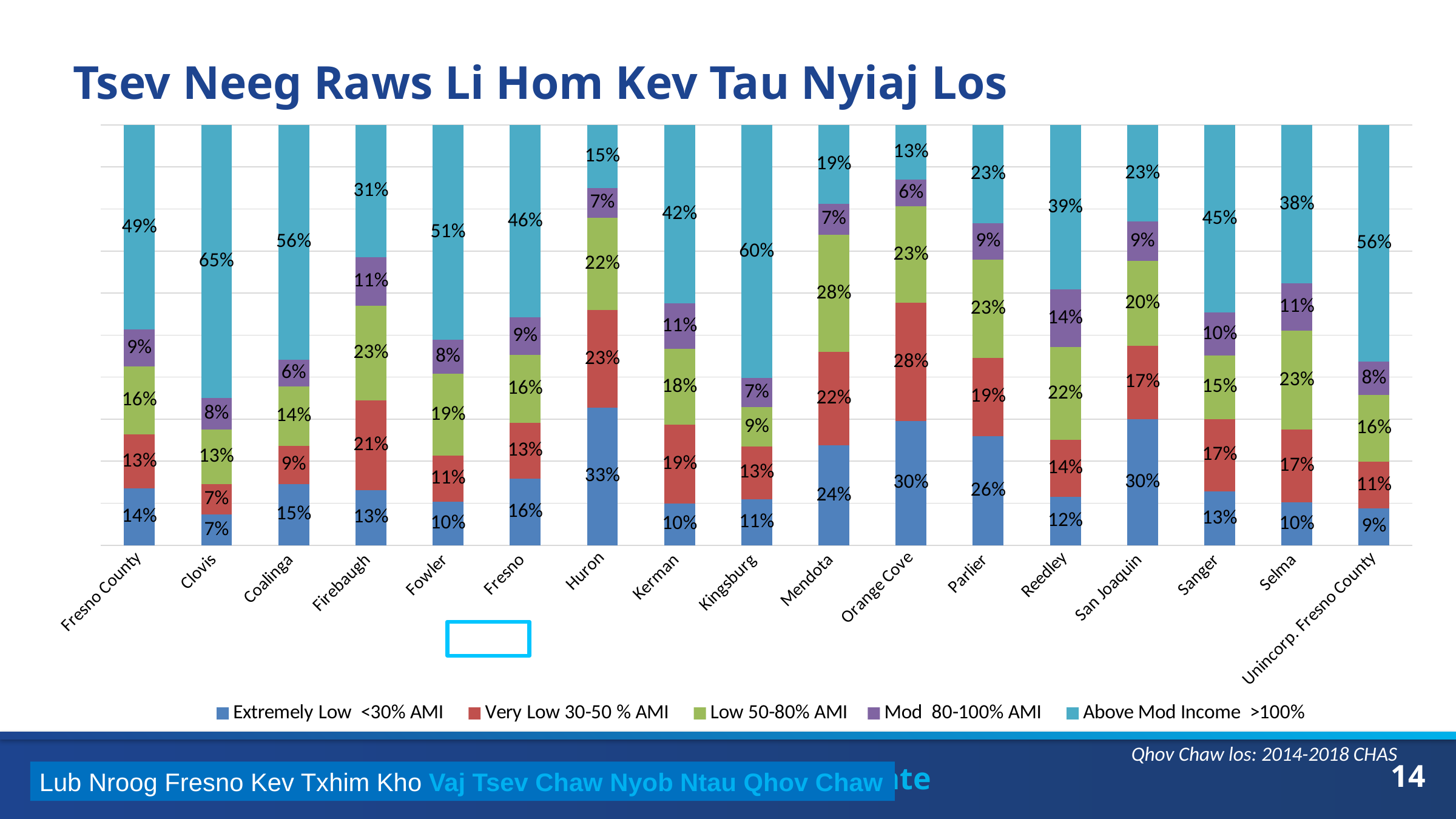
Which category has the highest Above Mod Income >100% value? Clovis How many series does the legend list? 5 Which category has the lowest Above Mod Income >100% value? Orange Cove Which is larger, the Very Low 30-50 % AMI value for Orange Cove or for Reedley? Orange Cove What is the Mod 80-100% AMI value for Reedley? 14% What is the difference between the Above Mod Income >100% values for Kingsburg and Firebaugh? 29% What is the Above Mod Income >100% value for Clovis? 65% Which category has the highest Extremely Low <30% AMI value? Huron What is the Extremely Low <30% AMI value for Huron? 33% What kind of chart is shown on the slide? stacked bar chart What is the Low 50-80% AMI value for Mendota? 28% How many categories are shown along the x axis? 17